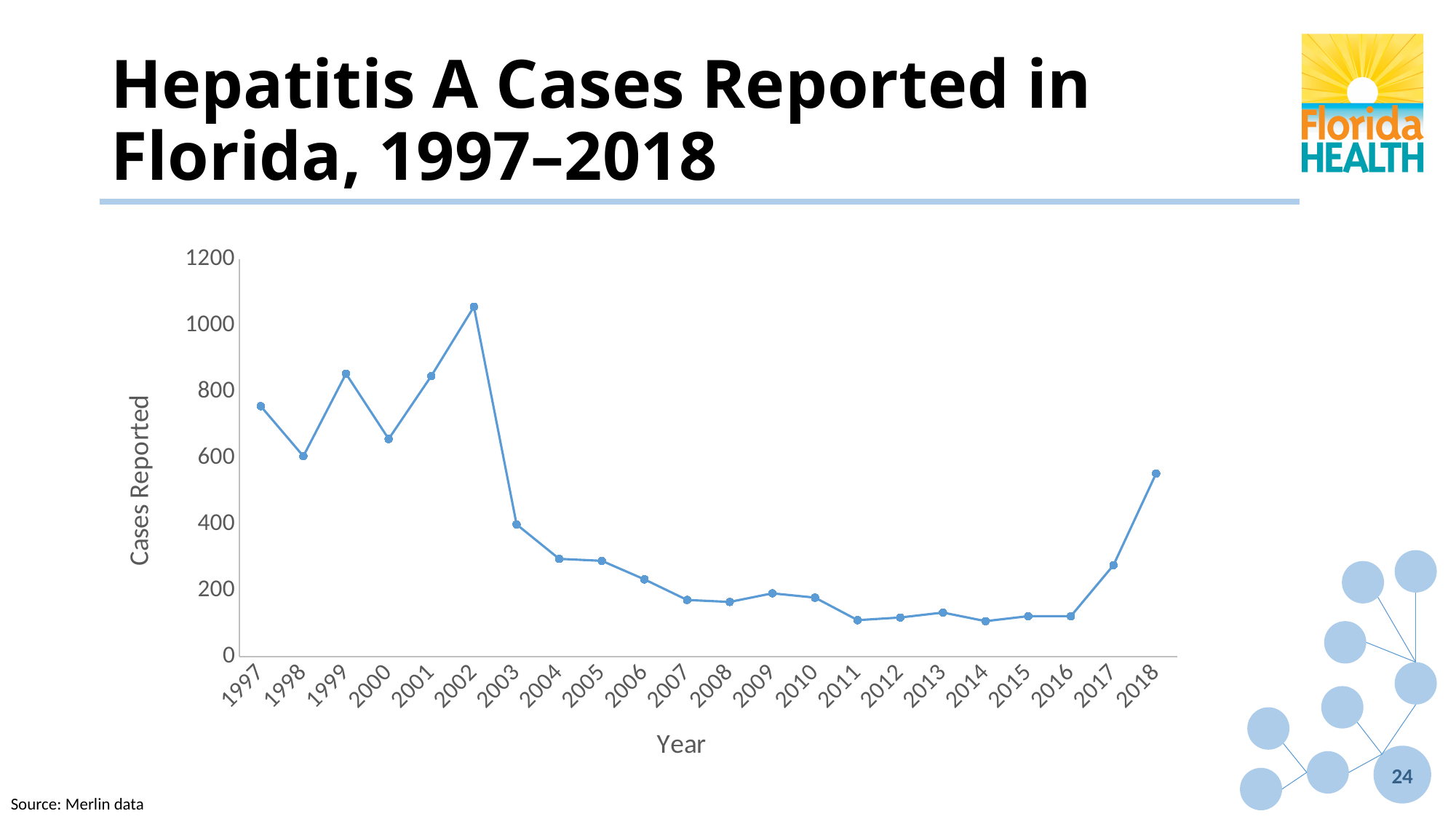
Is the value for 1997 greater or less than 600? greater Which year has the highest number of cases reported? 2002 Is the value for 2003 greater or less than 600? less Is the value for 2018 greater or less than 400? greater Do the values rise or fall from 2002 to 2007? fall What is the label on the y axis? Cases Reported Which year has more cases reported, 1999 or 2000? 1999 Which year has more cases reported, 2017 or 2018? 2018 How many years are plotted on the x axis? 22 What kind of chart is shown on the slide? line chart